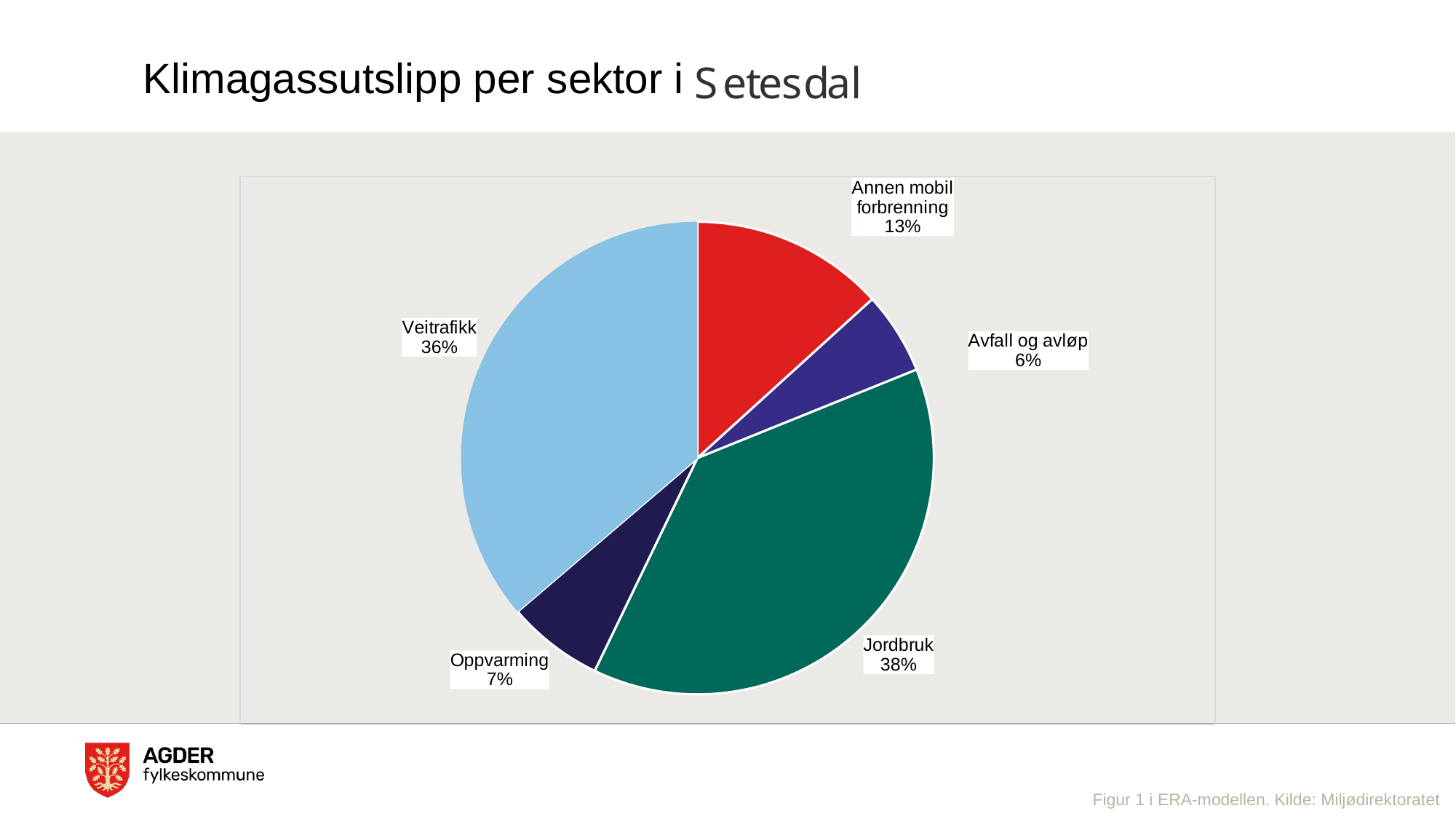
What kind of chart is shown on the slide? Pie chart Which is larger, Annen mobil forbrenning or Oppvarming? Annen mobil forbrenning What share of the pie does Veitrafikk represent? 36% How many sectors are shown in the pie chart? 5 What is the value shown for Annen mobil forbrenning? 13% Which sector has the largest share of emissions? Jordbruk What is the difference in percentage points between Jordbruk and Veitrafikk? 2 What share of the pie does Jordbruk represent? 38% Which sector has the smallest share of emissions? Avfall og avløp What is the difference in percentage points between Annen mobil forbrenning and Oppvarming? 6 What is the value shown for Oppvarming? 7% What is the value shown for Avfall og avløp? 6%